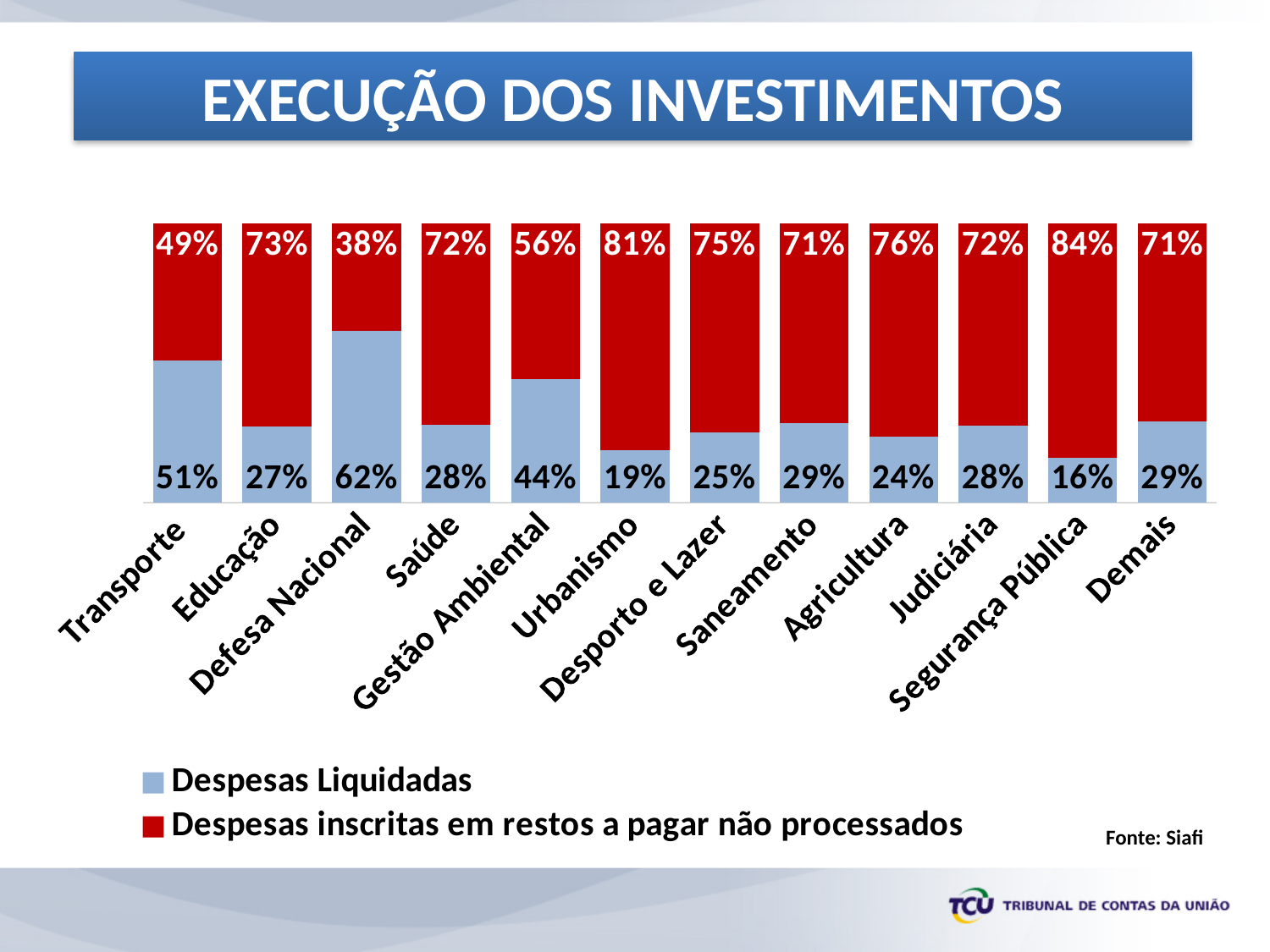
How many categories are shown on the x axis? 12 Which category has the highest value for Despesas inscritas em restos a pagar não processados? Segurança Pública What is the value of Despesas Liquidadas for Defesa Nacional? 62% What is the difference between the Despesas Liquidadas values for Transporte and Educação? 24% Which is larger: Despesas Liquidadas for Gestão Ambiental or for Saúde? Gestão Ambiental What is the value of Despesas inscritas em restos a pagar não processados for Urbanismo? 81% Which category has the highest value for Despesas Liquidadas? Defesa Nacional What is the title of the chart? EXECUÇÃO DOS INVESTIMENTOS What kind of chart is shown on the slide? Stacked bar chart What is the value of Despesas Liquidadas for Segurança Pública? 16% How many series does the legend list? 2 Which category has the lowest value for Despesas Liquidadas? Segurança Pública